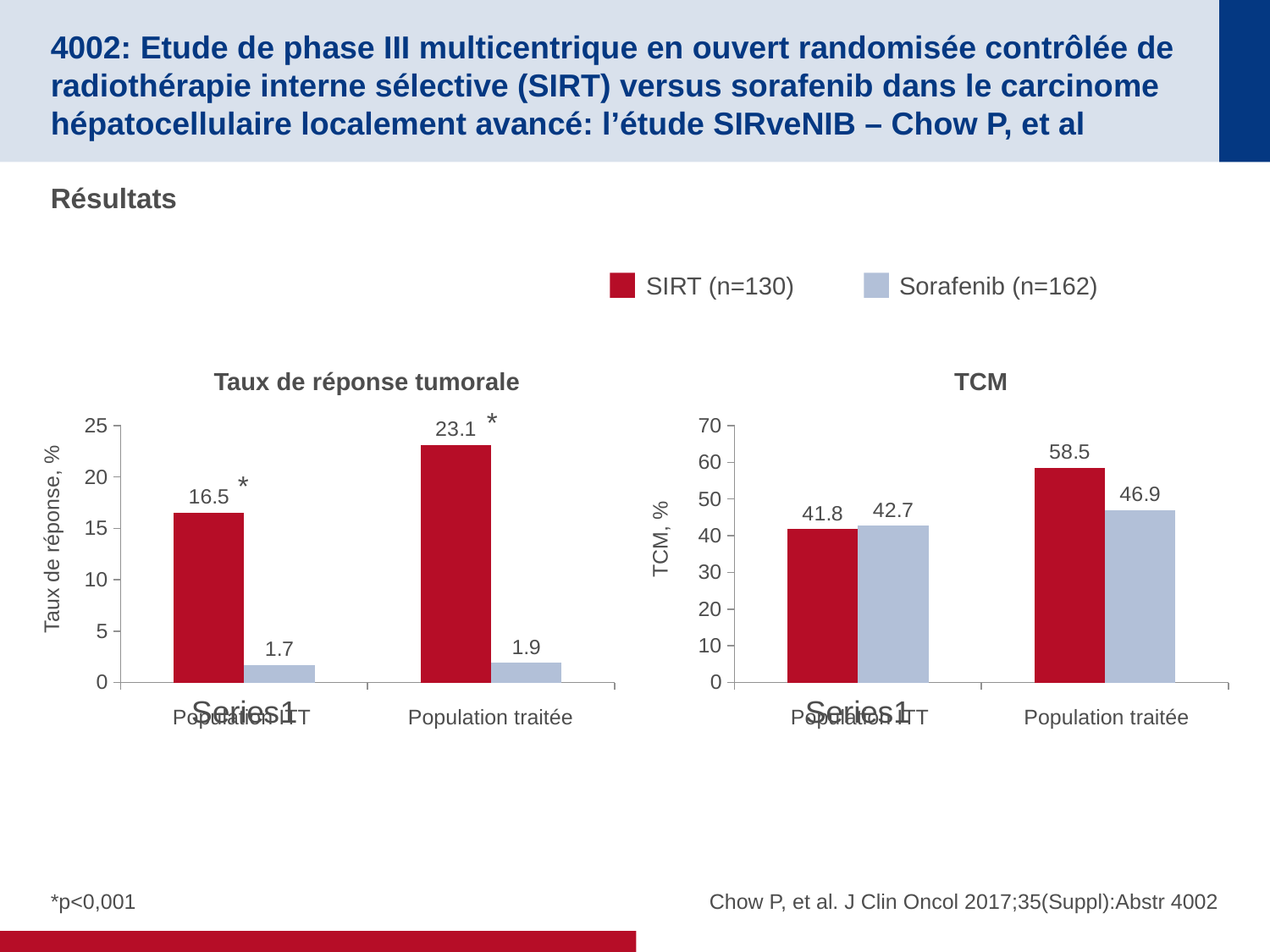
In the 'Taux de réponse tumorale' chart, what is the difference between SIRT and Sorafenib in the Population traitée? 21.2 In the 'Taux de réponse tumorale' chart, which bar is the highest? SIRT, Population traitée In the 'TCM' chart, what is the difference between SIRT and Sorafenib in the Population traitée? 11.6 What kind of chart is the 'TCM' chart? Bar chart In the 'TCM' chart, what is the value for SIRT in the Population traitée? 58.5 How many series does the legend list? 2 In the 'Taux de réponse tumorale' chart, what is the value for Sorafenib in the Population ITT? 1.7 In the 'Taux de réponse tumorale' chart, what is the value for SIRT in the Population traitée? 23.1 In the 'TCM' chart, which bar is the lowest? SIRT, Population ITT In the 'TCM' chart, what is the value for Sorafenib in the Population ITT? 42.7 In the 'TCM' chart, which is larger in the Population ITT, SIRT or Sorafenib? Sorafenib What is the y-axis label of the 'Taux de réponse tumorale' chart? Taux de réponse, %